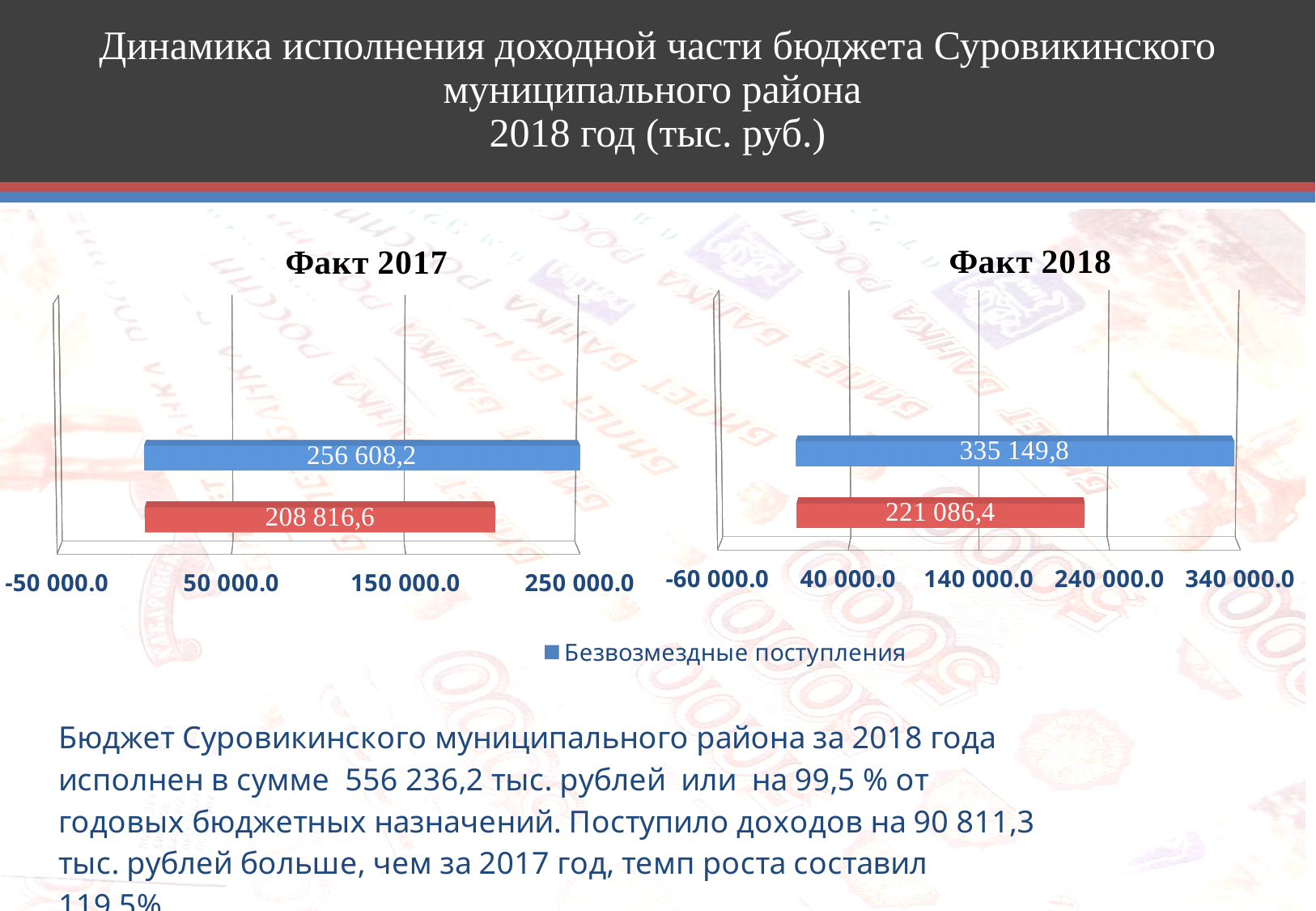
What series name is shown in the legend below the charts? Безвозмездные поступления In the Факт 2018 chart, what is the difference between the blue bar and the red bar? 114 063,4 In the Факт 2017 chart, is the value of the red bar greater or less than 150 000.0? greater Is the value of Безвозмездные поступления larger in the Факт 2017 chart or in the Факт 2018 chart? Факт 2018 In the Факт 2017 chart, what is the value of the red bar? 208 816,6 In the Факт 2018 chart, what is the value of the red bar? 221 086,4 In the Факт 2017 chart, what is the difference between the blue bar and the red bar? 47 791,6 In the Факт 2018 chart, which bar is larger, the blue one or the red one? The blue one (Безвозмездные поступления) In the Факт 2018 chart, what is the value of the blue bar (Безвозмездные поступления)? 335 149,8 How many bars are plotted in the Факт 2018 chart? 2 What type of chart is used for Факт 2017 and Факт 2018? Bar chart In the Факт 2017 chart, what is the value of the blue bar (Безвозмездные поступления)? 256 608,2